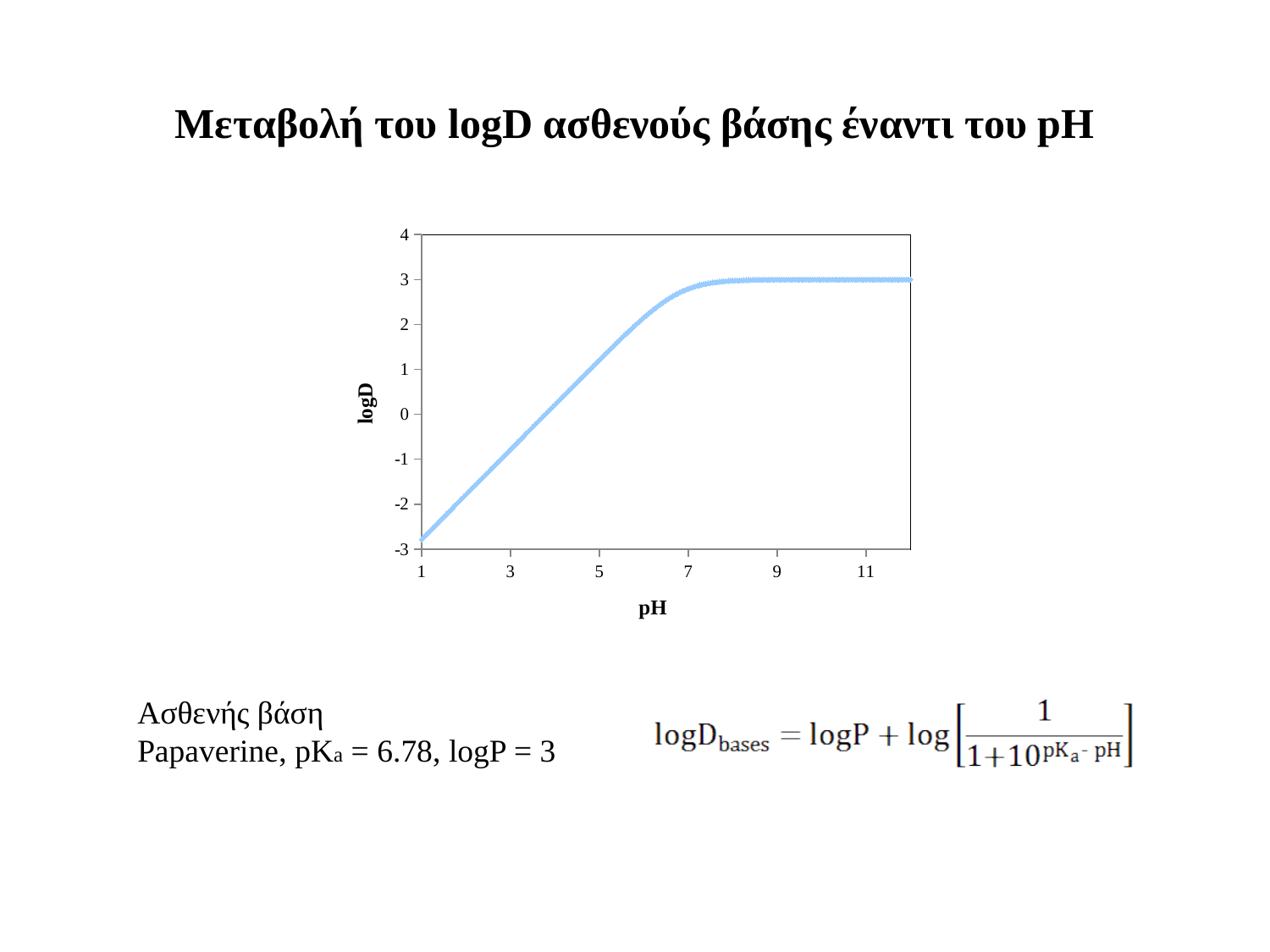
Which has the larger logD value, pH 3 or pH 9? pH 9 Is the logD value at pH 1 greater or less than -2? less What kind of chart is shown on the slide? line chart What is the label of the x axis of the chart? pH Is the logD value at pH 3 greater or less than 0? less Is the logD value at pH 5 greater or less than 0? greater What is the title of the chart on the slide? Μεταβολή του logD ασθενούς βάσης έναντι του pH How many tick labels are shown on the pH axis? 6 Does logD rise or fall as pH increases from 1 to 7? rise What is the highest logD value the curve reaches (the plateau level)? 3